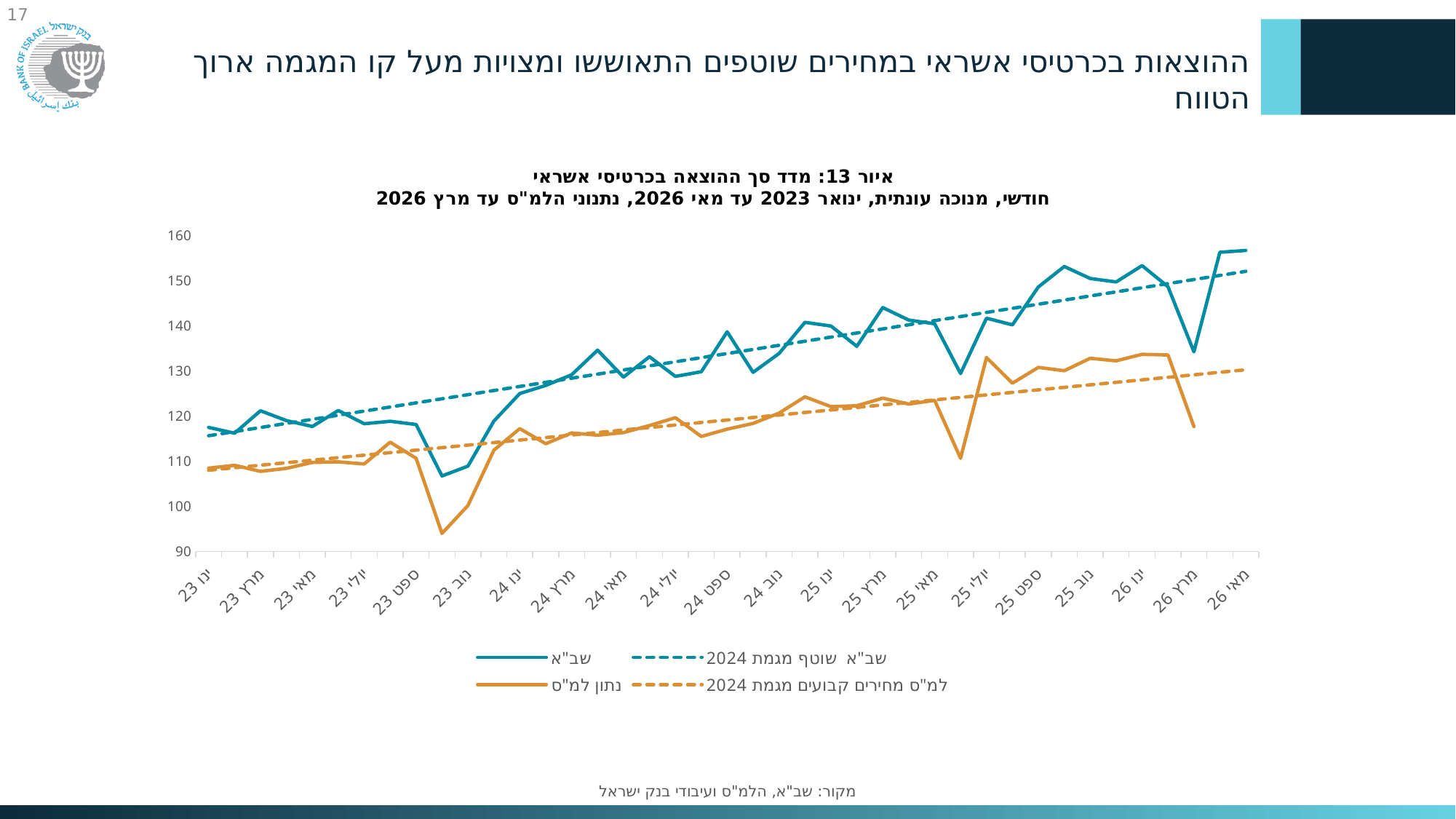
How many series does the legend list? 4 At ינו 26, which series is higher: שב"א or נתון למ"ס? שב"א What is the figure number given in the chart title? 13 Is the value of the שב"א series at מאי 26 greater or less than 150? greater Which legend entry is drawn as a solid orange line? נתון למ"ס At which x-axis label does the שב"א series reach its highest point? מאי 26 Does the שב"א series rise or fall overall from ינו 23 to מאי 26? rise What kind of chart is shown on the slide? line chart Is the value of the שב"א series at ינו 23 greater or less than 110? greater How many labels are shown on the x axis? 21